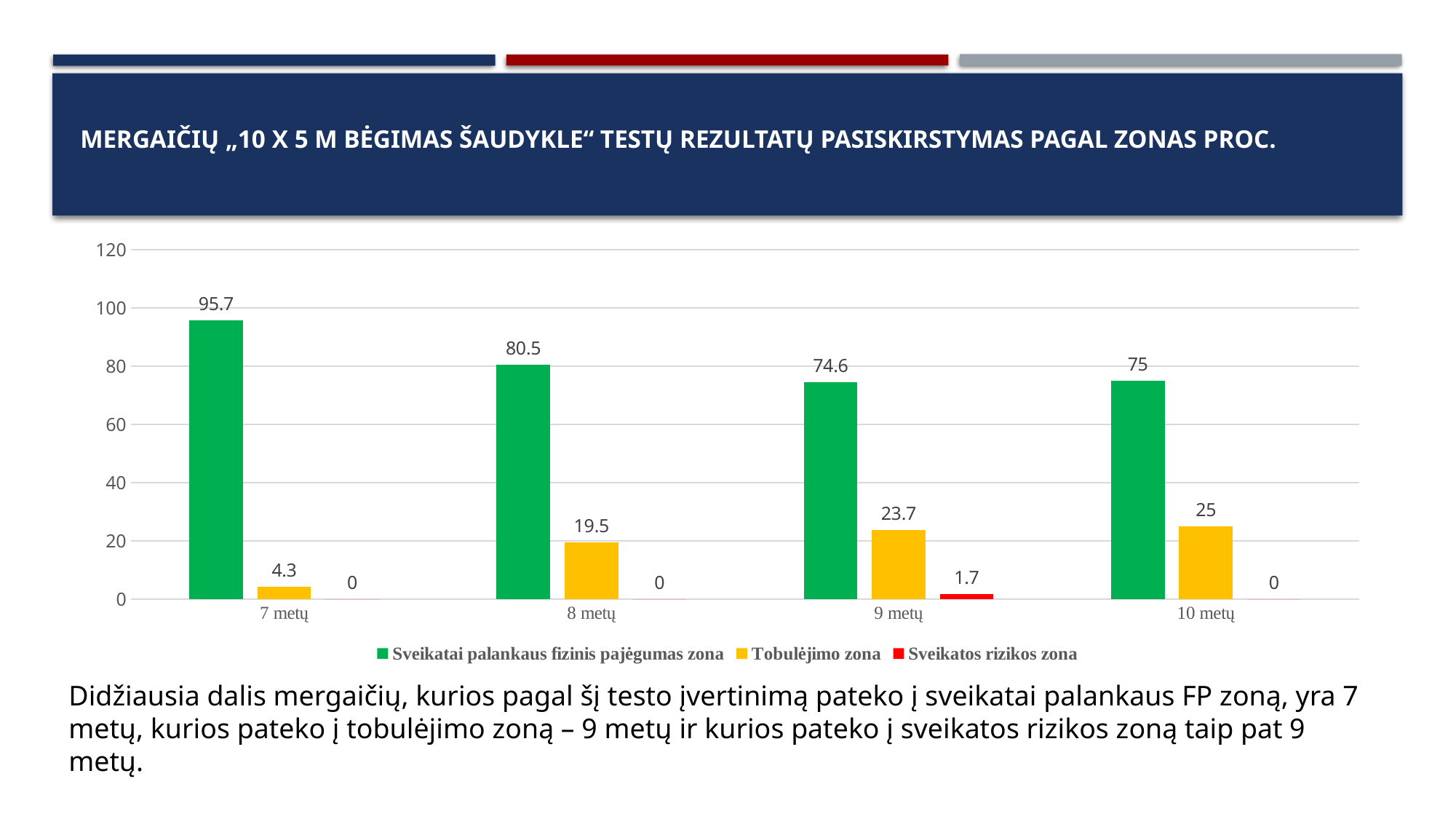
What kind of chart is shown on the slide? Bar chart Which is larger: the 'Tobulėjimo zona' value for 8 metų or for 10 metų? 10 metų What is the difference between the 'Sveikatai palankaus fizinis pajėgumas zona' values for 7 metų and 8 metų? 15.2 What is the value for 'Tobulėjimo zona' for 9 metų? 23.7 What colour represents 'Sveikatos rizikos zona' in the chart? Red How many series does the legend list? 3 What is the value for 'Sveikatai palankaus fizinis pajėgumas zona' for 7 metų? 95.7 How many age groups are shown on the x axis? 4 What is the value for 'Sveikatos rizikos zona' for 9 metų? 1.7 Which age group has the highest value for 'Sveikatai palankaus fizinis pajėgumas zona'? 7 metų Which age group has the lowest value for 'Tobulėjimo zona'? 7 metų What is the value for 'Tobulėjimo zona' for 10 metų? 25